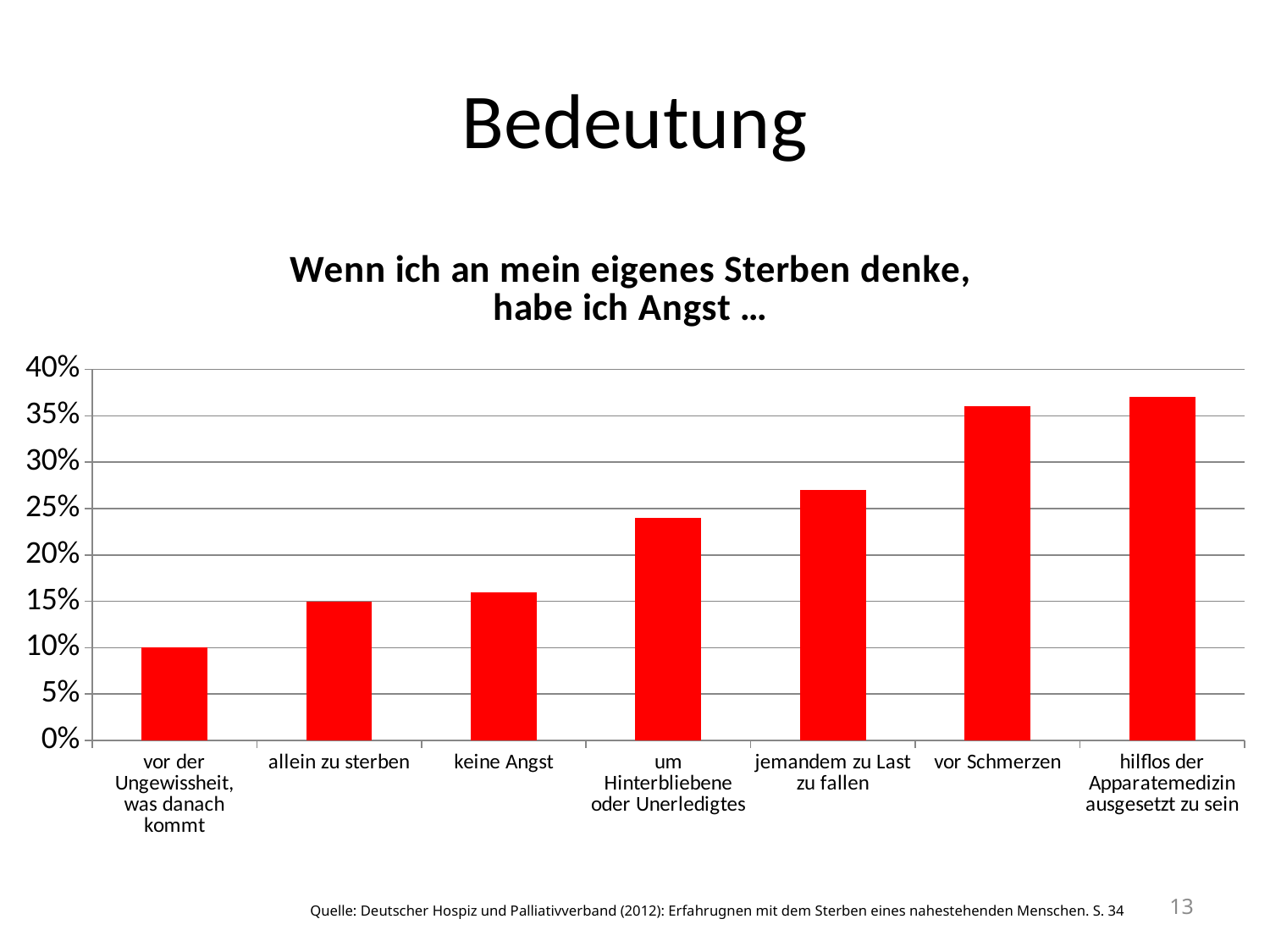
How many categories are shown on the x axis of the chart? 7 Do the values rise or fall from left to right along the x axis? rise Is the value for "um Hinterbliebene oder Unerledigtes" greater or less than 20%? greater Is the value for "keine Angst" greater or less than 20%? less Is the value for "hilflos der Apparatemedizin ausgesetzt zu sein" greater or less than 40%? less Which category has the lowest value? vor der Ungewissheit, was danach kommt Which is larger, the value for "vor Schmerzen" or the value for "jemandem zu Last zu fallen"? vor Schmerzen What is the value for "allein zu sterben"? 15% What is the title of the chart? Wenn ich an mein eigenes Sterben denke, habe ich Angst … What kind of chart is shown on the slide? bar chart What is the value for "vor der Ungewissheit, was danach kommt"? 10%